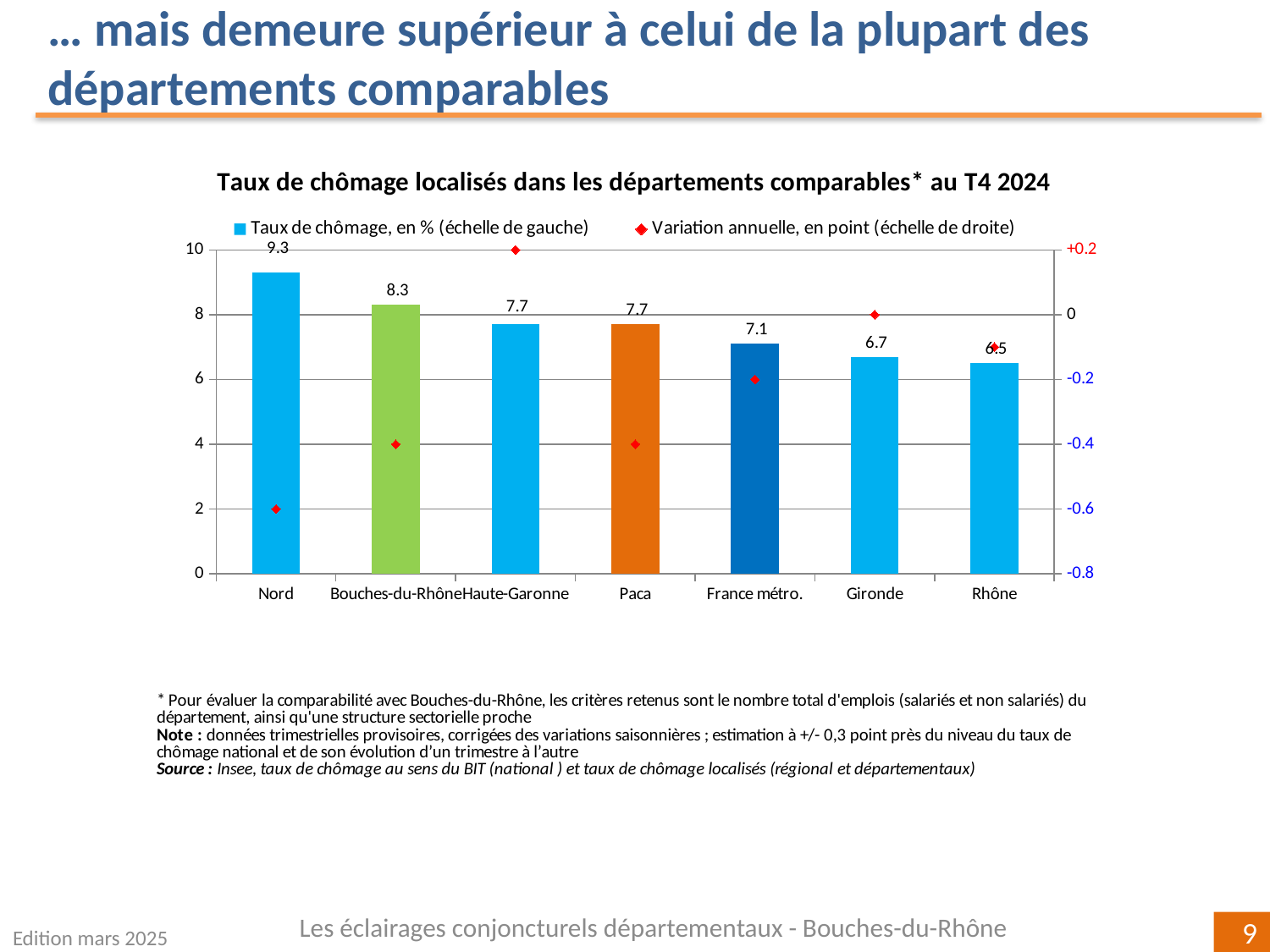
Which category has the lowest unemployment rate bar? Rhône Is the annual variation for Haute-Garonne greater or less than 0? greater What is the title of the chart? Taux de chômage localisés dans les départements comparables* au T4 2024 Is the annual variation (Variation annuelle) for Nord greater or less than -0.4? less What is the unemployment rate shown for France métro.? 7.1 Which category has the highest unemployment rate bar? Nord What is the unemployment rate shown for Bouches-du-Rhône? 8.3 How many categories are shown on the x axis? 7 Which has a higher unemployment rate, Gironde or France métro.? France métro. What is the difference between the unemployment rates of Nord and Bouches-du-Rhône? 1.0 How many series does the legend list? 2 What is the unemployment rate (Taux de chômage) shown for Nord? 9.3